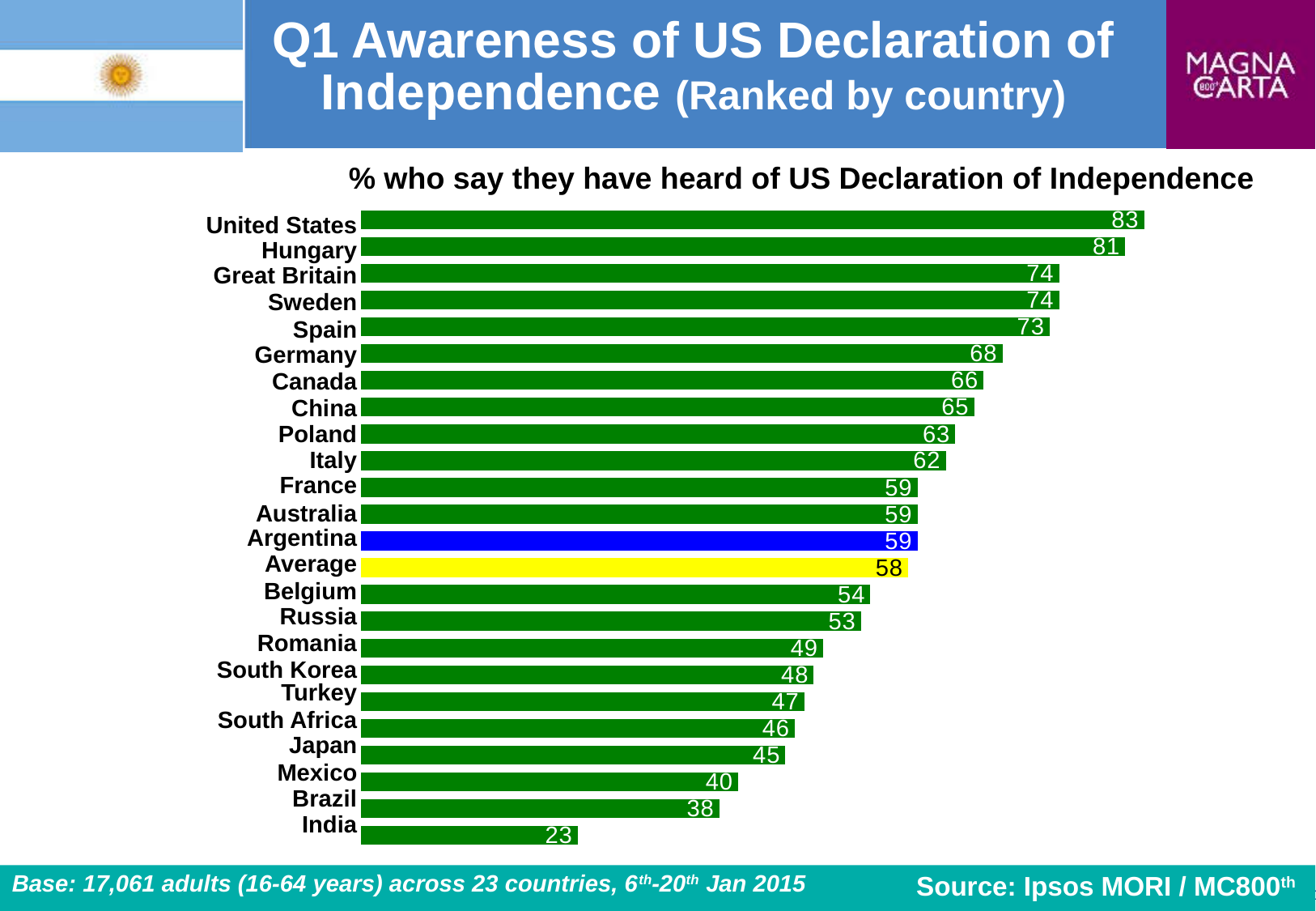
What is the difference between the values for Hungary and Spain? 8 What is the value for Argentina? 59 Which is larger, the value for Canada or the value for Russia? Canada How many bars are shown in the chart, including Average? 24 Which country has the highest value? United States What is the value for Germany? 68 What kind of chart is shown on the slide? Bar chart What is the difference between the values for United States and India? 60 Which bar is coloured blue? Argentina Which country has the lowest value? India Which bar is coloured yellow? Average What is the value shown for Average? 58